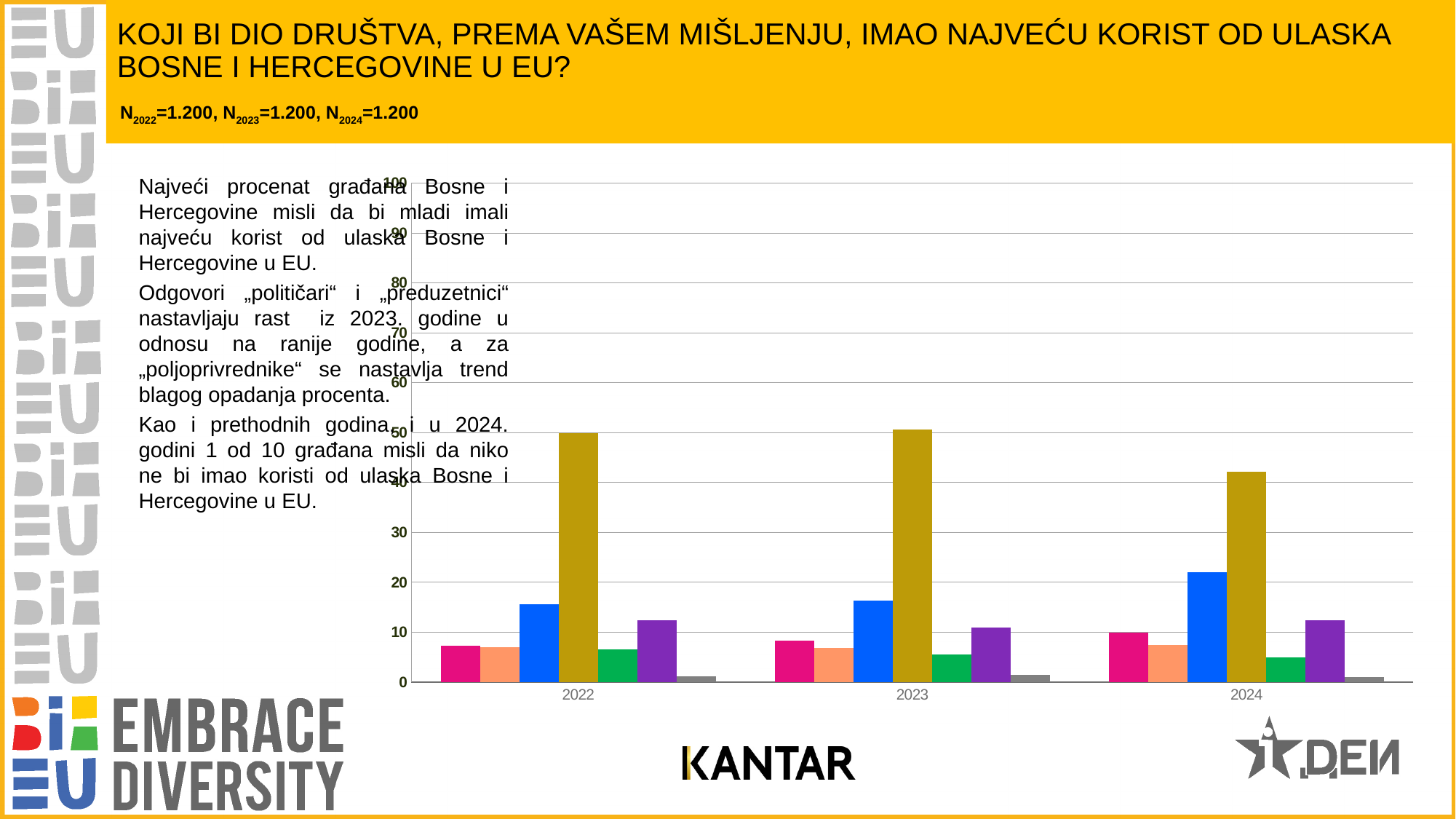
Which colour bar is the tallest in every year of the chart? gold In which year is the gold bar the lowest? 2024 How many bars are plotted for each year in the chart? 7 Is the value of the gold bar for 2024 greater or less than 50? less Is the value of the gold bar for 2022 greater or less than 40? greater How many years (categories) are shown on the x axis of the chart? 3 What kind of chart is shown on the slide? bar chart Is the value of the blue bar for 2024 greater or less than 20? greater What is the highest value shown on the y axis of the chart? 100 Do the blue bars rise or fall from 2022 to 2024? rise In 2024, which is larger, the blue bar or the purple bar? blue bar